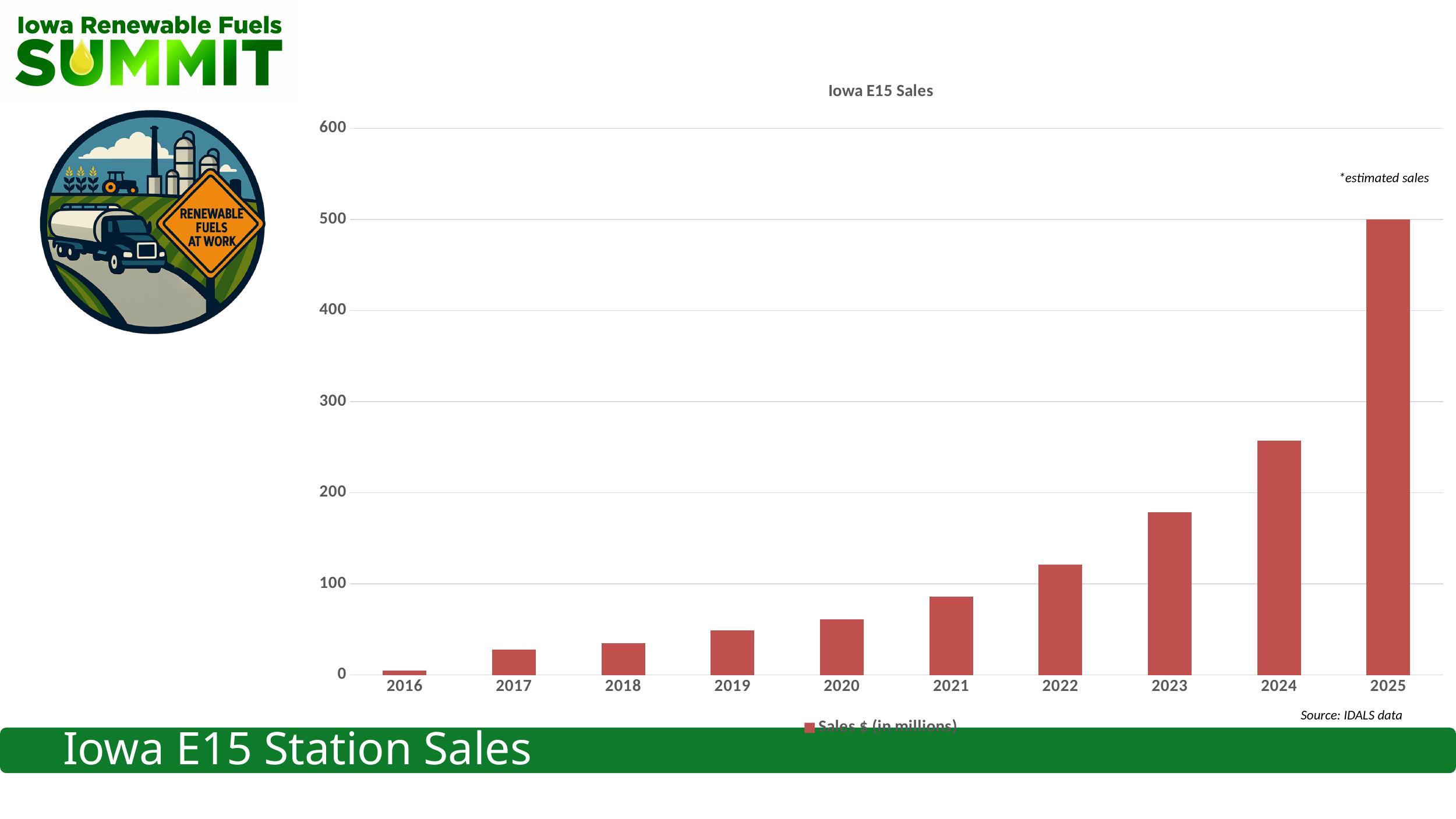
Which year has higher sales, 2023 or 2024? 2024 How many series does the chart's legend list? 1 Is the value for 2022 greater or less than 100? greater Which year has the highest Iowa E15 sales? 2025 Is the value for 2023 greater or less than 200? less How many years are shown on the x axis of the chart? 10 Do Iowa E15 sales rise or fall from 2016 to 2025? rise Is the value for 2021 greater or less than 100? less What is the title of the chart? Iowa E15 Sales Which year has the lowest Iowa E15 sales? 2016 What type of chart is shown on the slide? bar chart